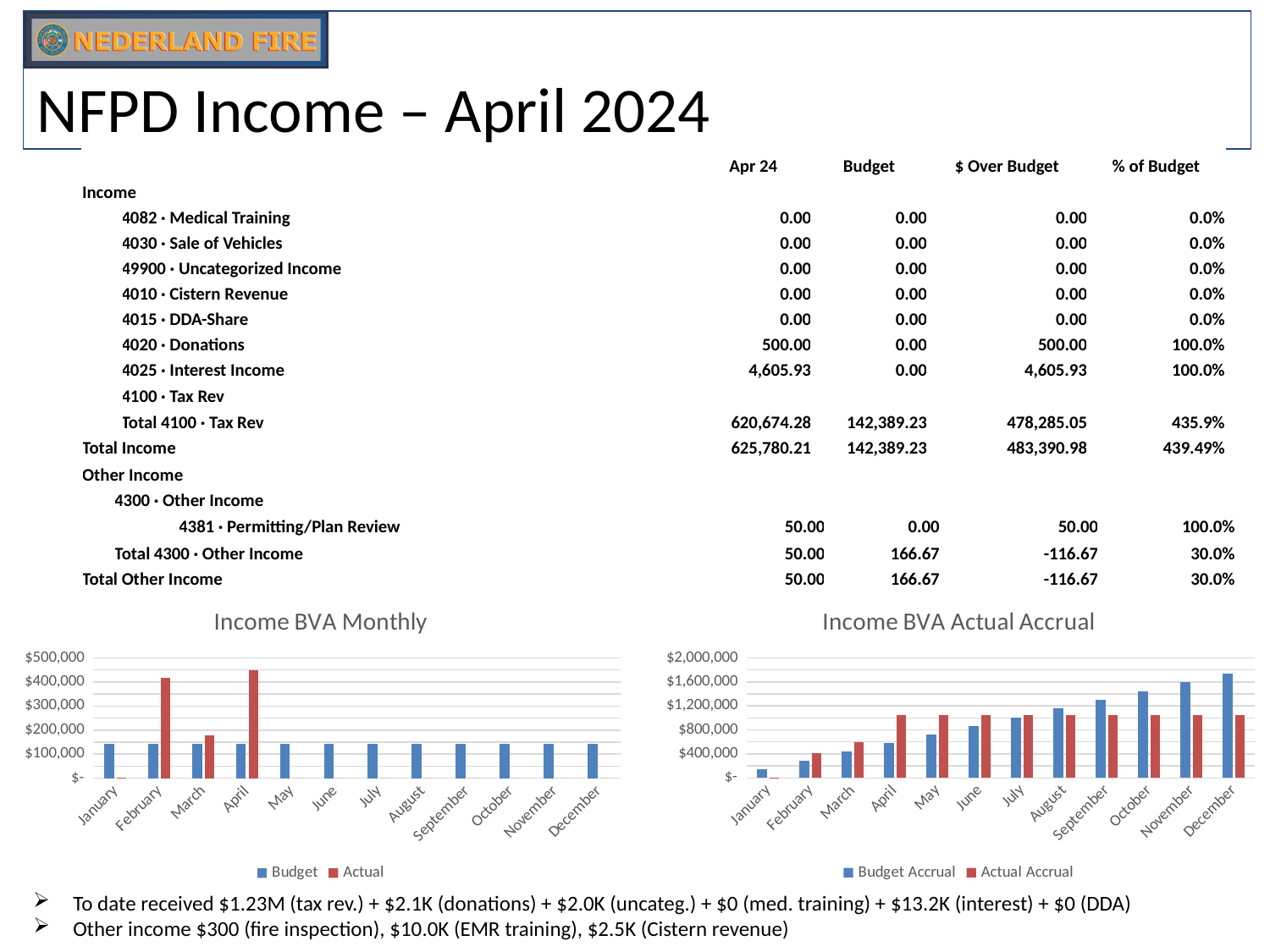
In the Income BVA Actual Accrual chart, does the Budget Accrual series rise or fall from January to December? rise What are the legend entries of the Income BVA Actual Accrual chart? Budget Accrual, Actual Accrual What kind of chart is the Income BVA Monthly chart? bar chart How many series does the legend of the Income BVA Monthly chart list? 2 In the Income BVA Monthly chart, is the Actual value for March greater or less than $200,000? less In the Income BVA Actual Accrual chart, which is larger for April: Budget Accrual or Actual Accrual? Actual Accrual In the Income BVA Actual Accrual chart, which is larger for December: Budget Accrual or Actual Accrual? Budget Accrual In the Income BVA Monthly chart, which month has the highest Actual value? April In the Income BVA Monthly chart, is the Budget value for January greater or less than $200,000? less In the Income BVA Monthly chart, is the Actual value for February greater or less than $300,000? greater How many months are shown on the x axis of the Income BVA Actual Accrual chart? 12